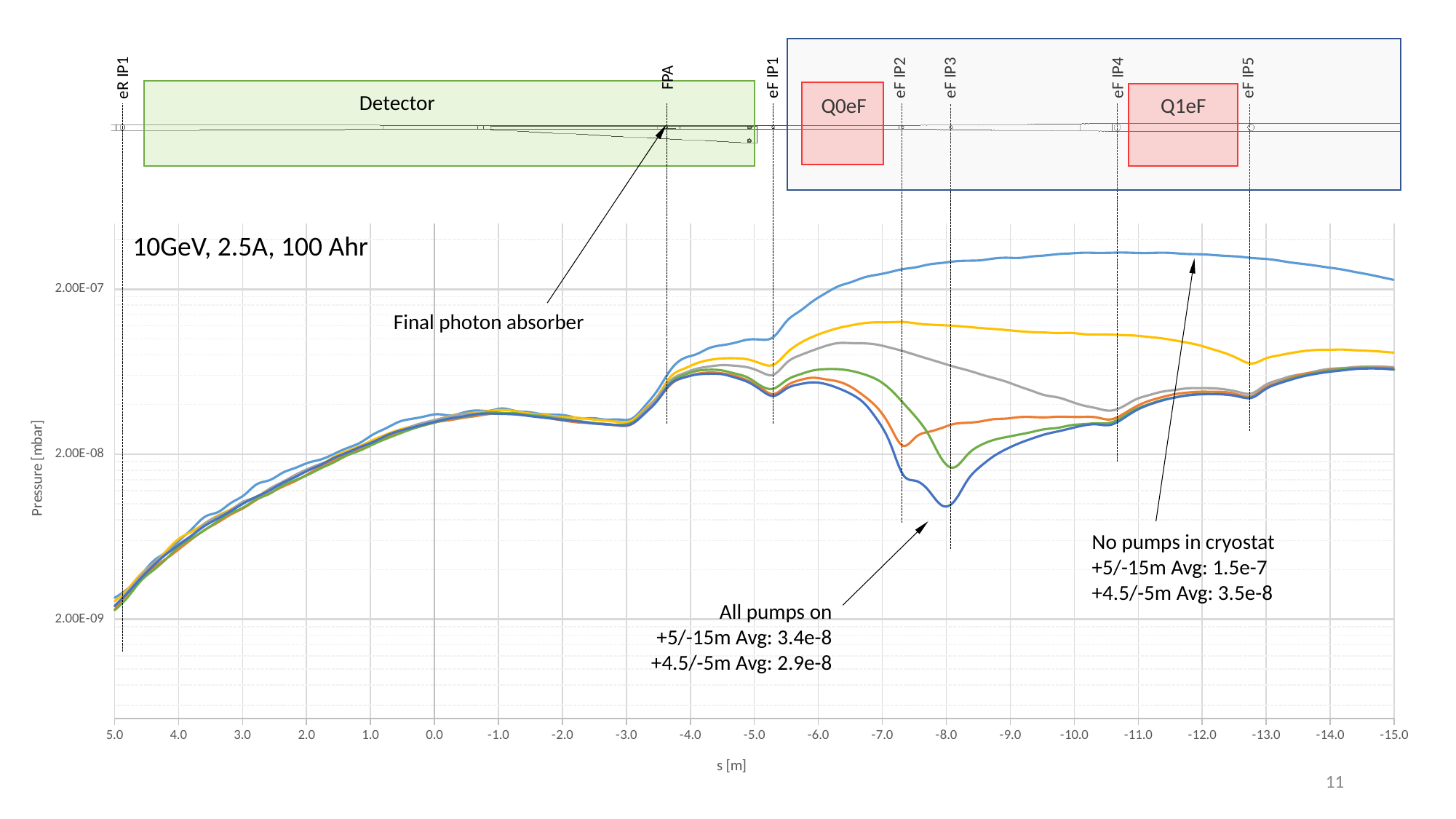
What is the label of the horizontal axis of the chart? s [m] What kind of chart is shown on the slide? line chart Is the pressure of the topmost (light blue) curve at s = -10.0 m greater or less than 2.00E-07 mbar? greater According to the annotation, what is the +4.5/-5m average pressure with no pumps in the cryostat? 3.5e-8 According to the annotation, what is the +5/-15m average pressure with all pumps on? 3.4e-8 Is the pressure of the lowest (dark blue) curve at s = -8.0 m greater or less than 2.00E-08 mbar? less At s = -10.0 m, which curve shows the higher pressure: the light blue curve or the dark blue curve? light blue curve What is the label of the vertical axis of the chart? Pressure [mbar] According to the annotation, what is the +4.5/-5m average pressure with all pumps on? 2.9e-8 Do the pressure curves rise or fall as s goes from 5.0 m to 0.0 m? rise According to the annotation, what is the +5/-15m average pressure with no pumps in the cryostat? 1.5e-7 Which case has the higher +5/-15m average pressure: all pumps on or no pumps in cryostat? No pumps in cryostat